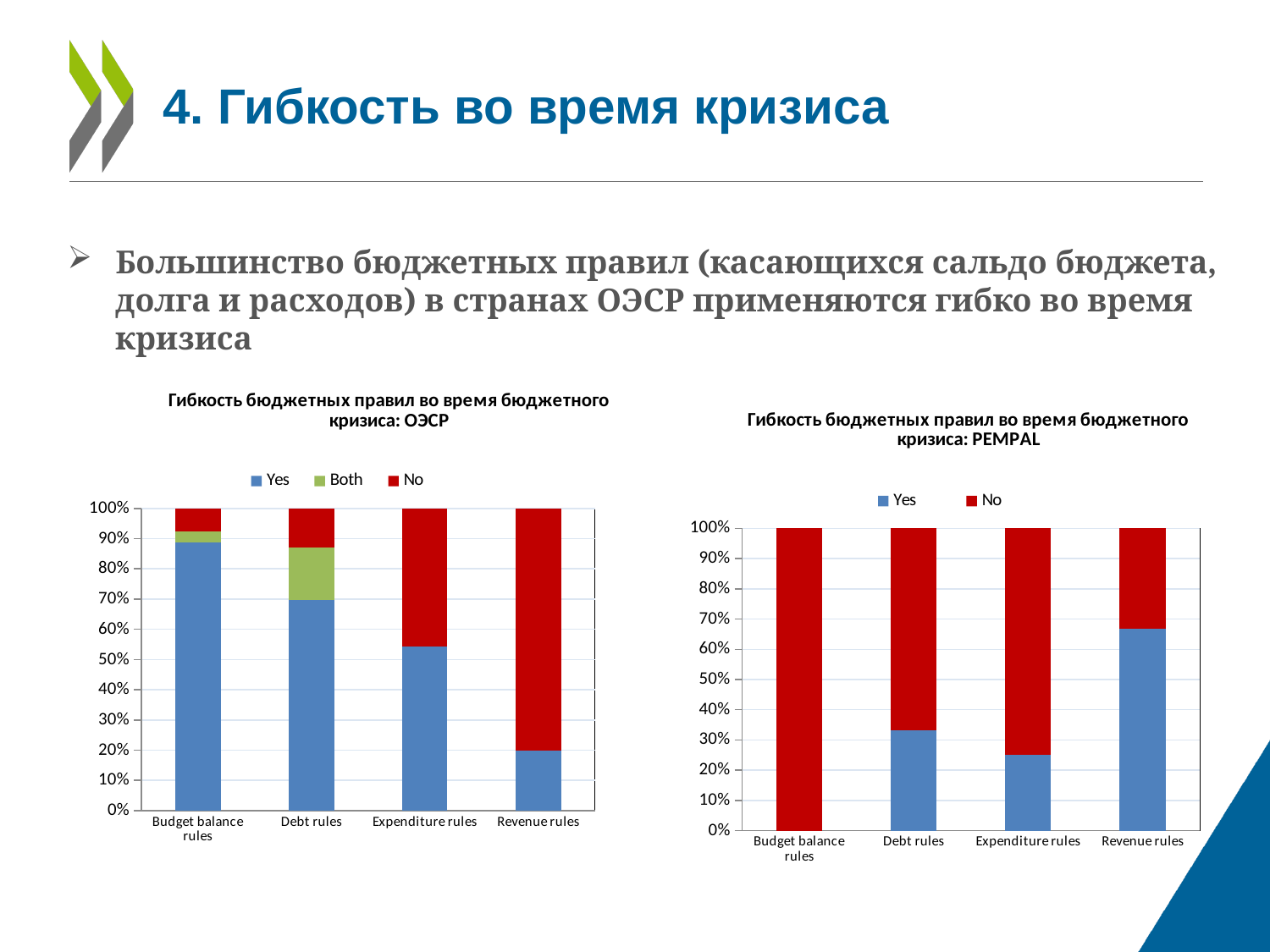
In the left chart (ОЭСР), which category has the largest "Yes" share? Budget balance rules How many series does the legend of the right chart (PEMPAL) list? 2 In the left chart (ОЭСР), is the "Yes" share for Revenue rules greater or less than 30%? less How many series does the legend of the left chart (ОЭСР) list? 3 In the right chart (PEMPAL), is the "Yes" share for Revenue rules greater or less than 60%? greater What kind of chart is the left chart titled "Гибкость бюджетных правил во время бюджетного кризиса: ОЭСР"? Stacked bar chart In the left chart (ОЭСР), which category has the smallest "Yes" share? Revenue rules Which series appears in the legend of the left chart (ОЭСР) but not in the legend of the right chart (PEMPAL)? Both In the right chart (PEMPAL), which category has the largest "No" share? Budget balance rules In the right chart (PEMPAL), which category has the largest "Yes" share? Revenue rules How many categories are shown on the x axis of the right chart (PEMPAL)? 4 In the left chart (ОЭСР), which category has a larger "Yes" share: Debt rules or Expenditure rules? Debt rules